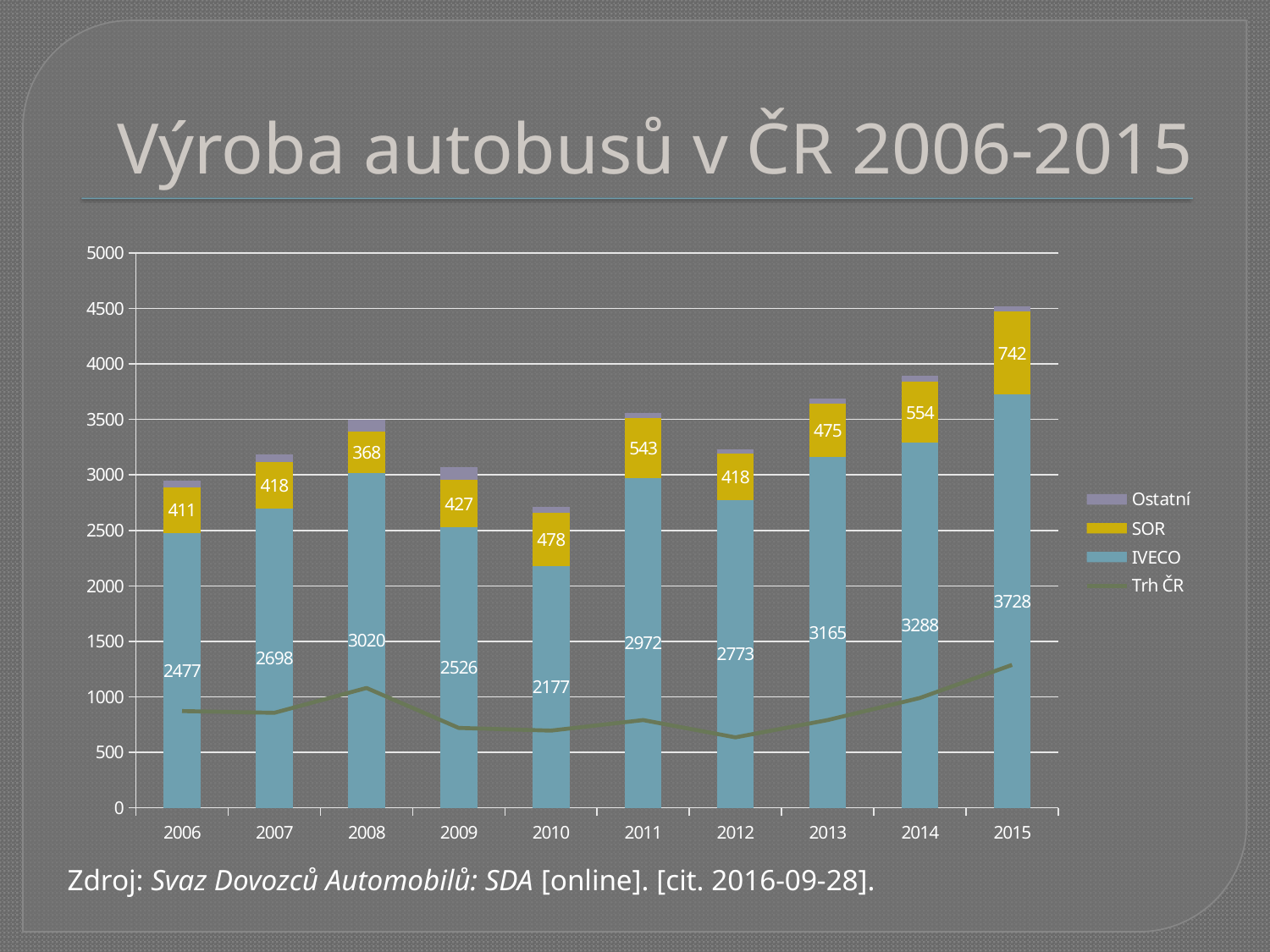
What is the difference between the IVECO values for 2015 and 2014? 440 How many years are shown on the x axis? 10 What is the IVECO value for 2009? 2526 In which year is the IVECO value the lowest? 2010 In which year is the IVECO value the highest? 2015 Is the Trh ČR value for 2015 greater or less than 1000? greater Which is larger, the SOR value for 2011 or the SOR value for 2013? 2011 In which year is the SOR value the lowest? 2008 What is the IVECO value for 2015? 3728 What is the SOR value for 2010? 478 How many series does the legend list? 4 What is the title of the chart? Výroba autobusů v ČR 2006-2015